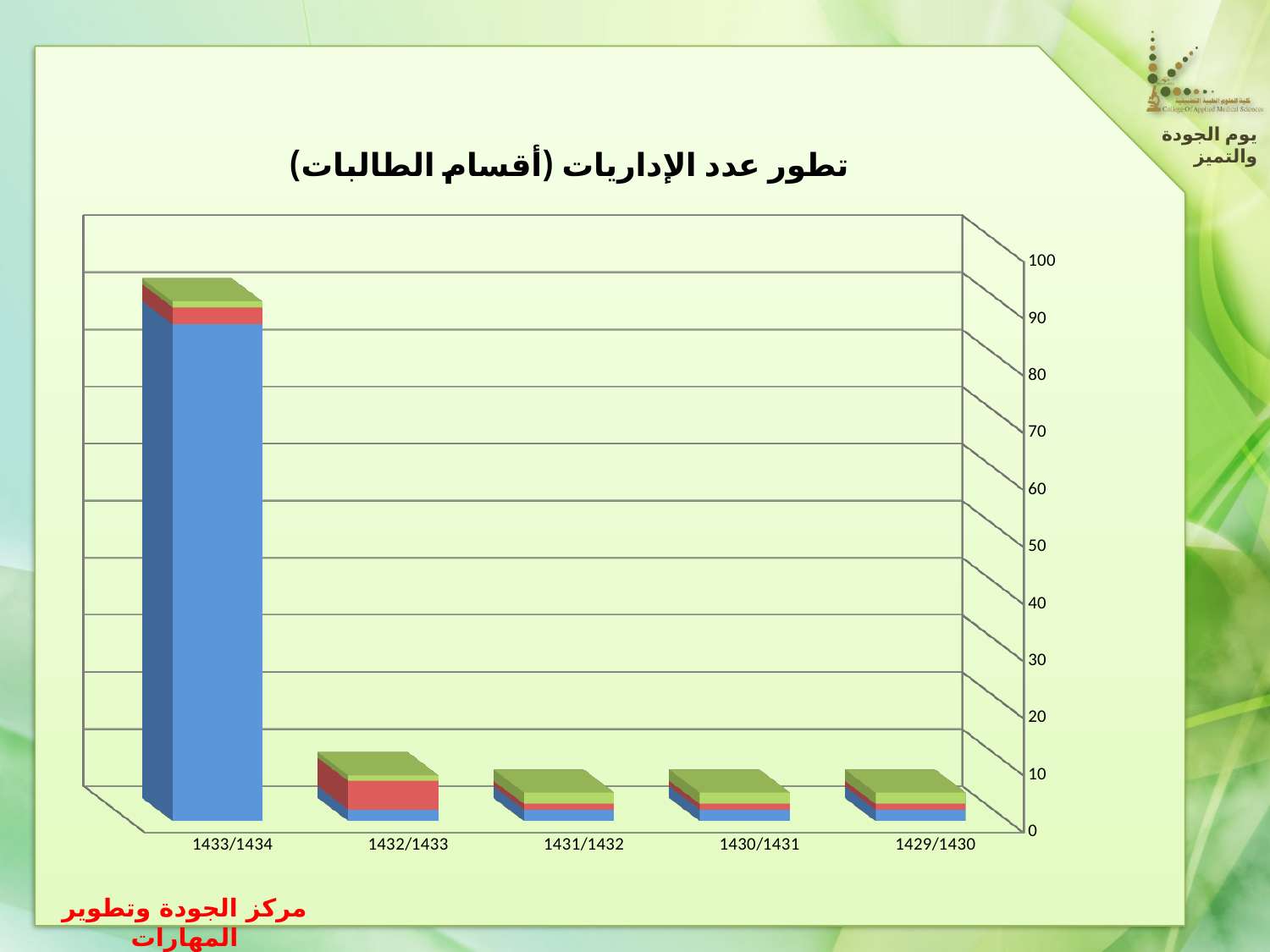
Which has a larger total bar, 1433/1434 or 1432/1433? 1433/1434 Is the total value for 1433/1434 greater or less than 70? greater What is the title of the chart? تطور عدد الإداريات (أقسام الطالبات) Is the total value for 1429/1430 greater or less than 20? less What kind of chart is shown on the slide? bar chart How many categories are shown on the x axis of the chart? 5 What is the highest value labelled on the vertical axis of the chart? 100 Do the bar totals rise or fall moving from left to right along the x axis? fall Which category has the highest total bar in the chart? 1433/1434 Is the total value for 1431/1432 greater or less than 30? less